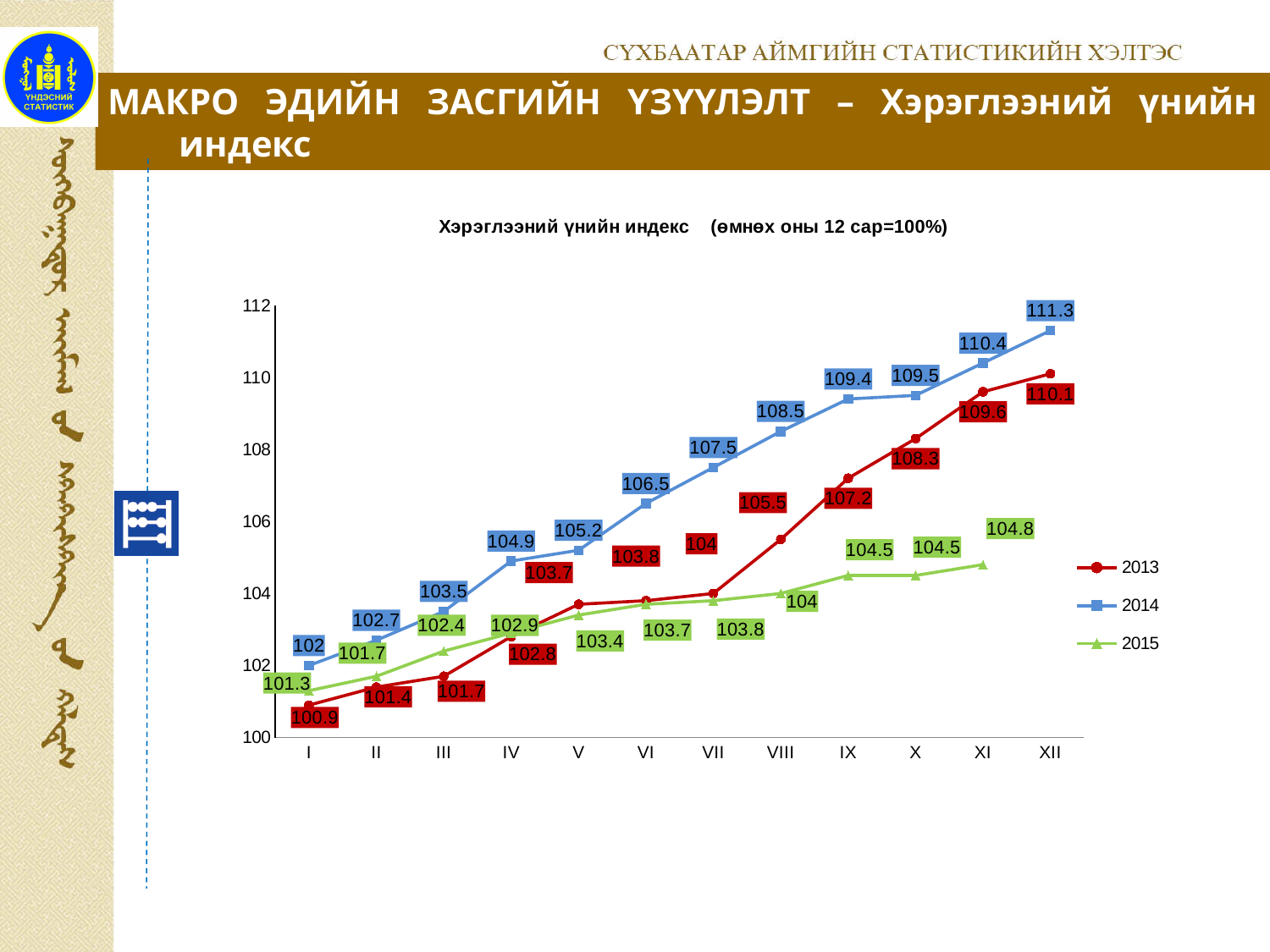
In which month does the 2014 series reach its highest value? XII What is the difference between the 2014 and 2013 values in month XII? 1.2 What is the value for 2014 in month XII? 111.3 How many months are shown on the x axis? 12 Does the 2014 series rise or fall from month I to month XII? Rise What is the value for 2013 in month I? 100.9 How many series does the legend list? 3 What is the value for 2013 in month VII? 104 What is the title of the chart? Хэрэглээний үнийн индекс (өмнөх оны 12 сар=100%) Which series has the larger value in month VIII, 2013 or 2014? 2014 What kind of chart is shown on the slide? Line chart What is the value for 2015 in month XI? 104.8